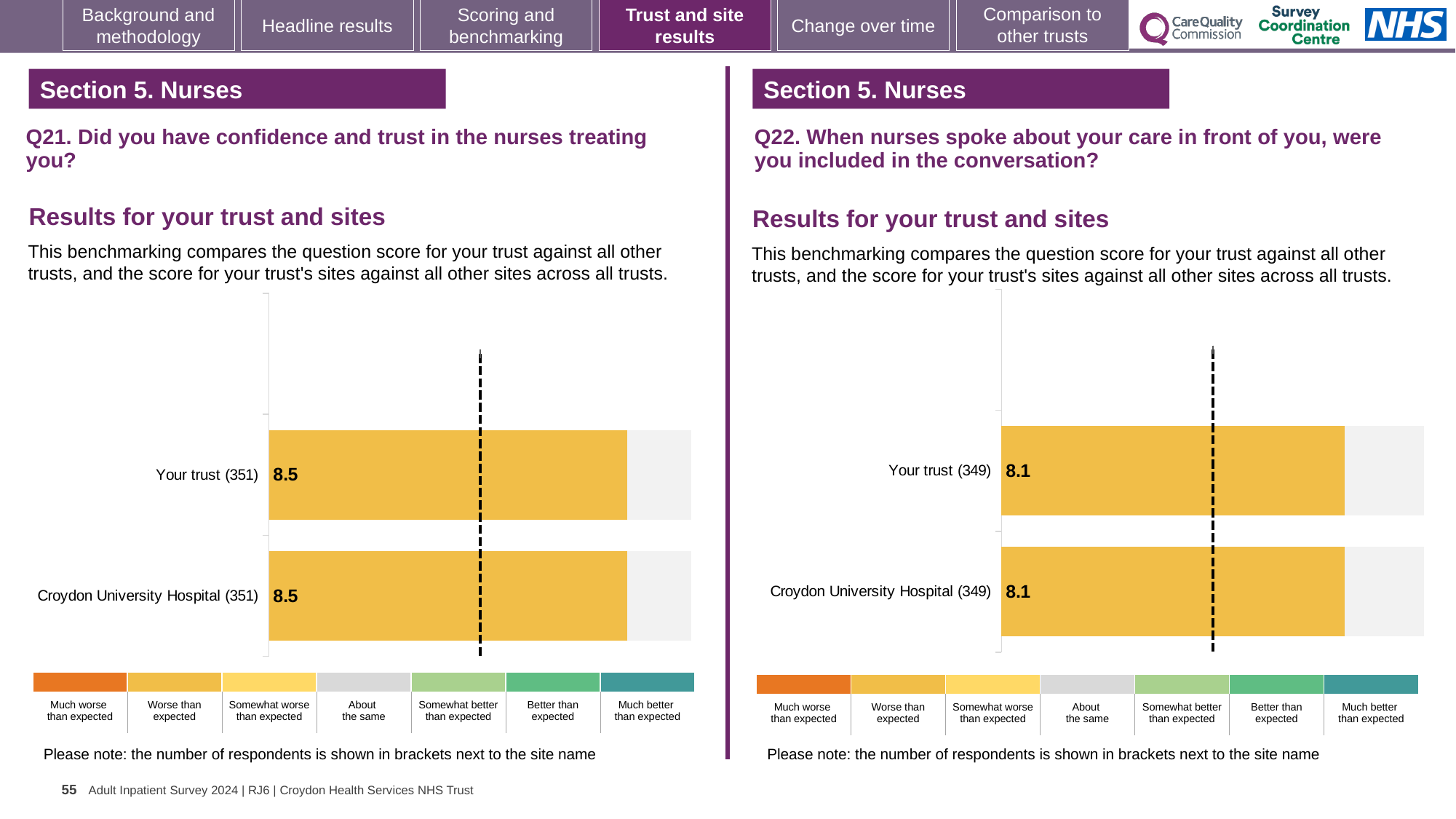
On the Q22 chart (right), what is the score for Your trust? 8.1 Which is larger: the Your trust score on the Q21 chart (left) or the Your trust score on the Q22 chart (right)? Q21 chart (left) On the Q21 chart (left), what is the score for Your trust? 8.5 What kind of chart is the Q21 chart (left)? Bar chart On the Q22 chart (right), how many respondents are shown in brackets for Croydon University Hospital? 349 On the Q21 chart (left), what is the difference between the score for Your trust and the score for Croydon University Hospital? 0 How many benchmark categories are shown in the colour key below the Q22 chart (right)? 7 How many bars are plotted on the Q22 chart (right)? 2 On the Q21 chart (left), how many respondents are shown in brackets for Your trust? 351 What is the difference between the Your trust score on the Q21 chart (left) and the Your trust score on the Q22 chart (right)? 0.4 On the Q22 chart (right), what is the score for Croydon University Hospital? 8.1 On the Q21 chart (left), what is the score for Croydon University Hospital? 8.5